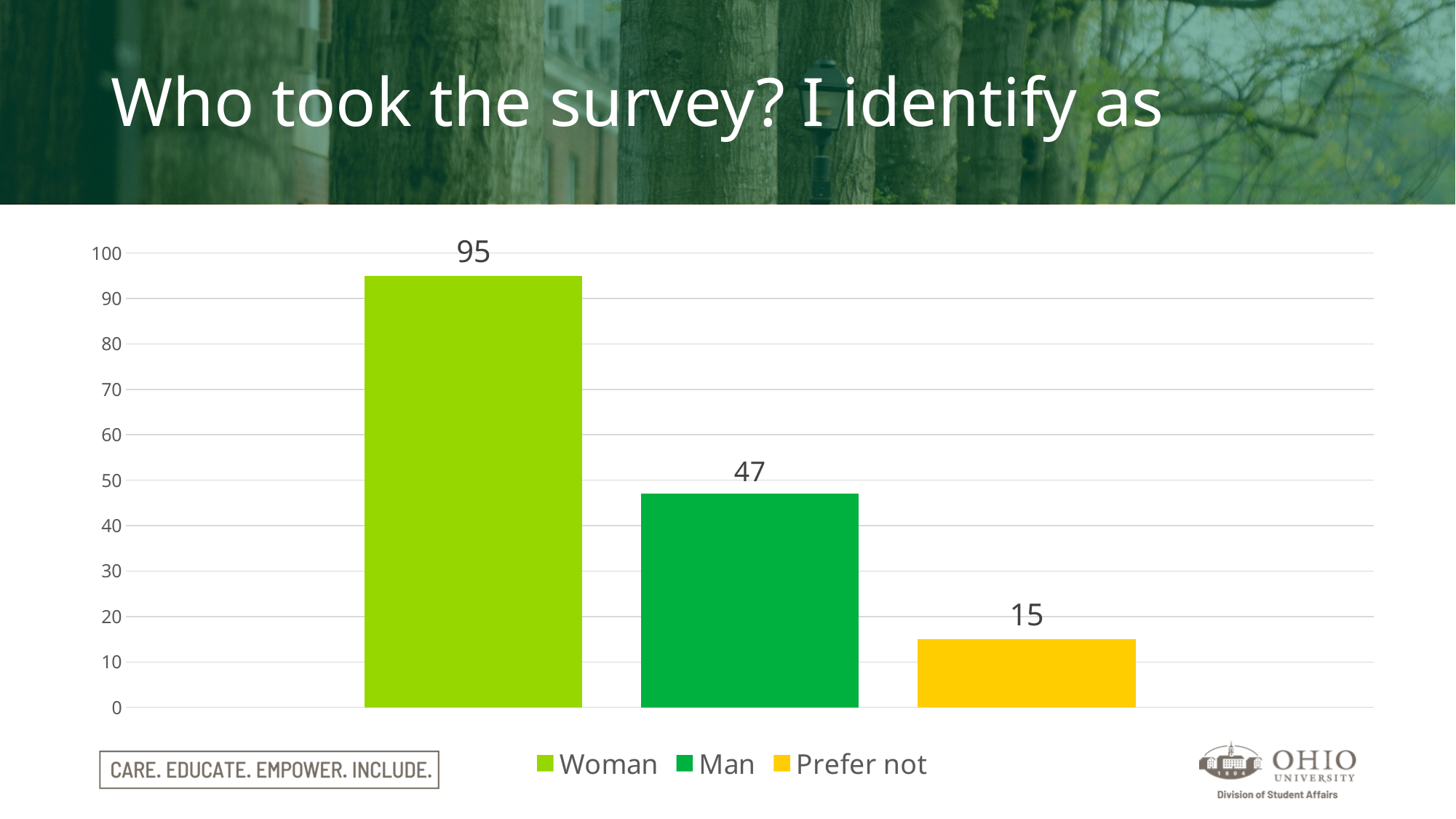
What is the title of the slide? Who took the survey? I identify as What is the difference between the values for Woman and Man? 48 What is the difference between the values for Man and Prefer not? 32 What is the value for Prefer not? 15 What is the value for Man? 47 Is the value for Man greater or less than 50? less How many categories are shown in the chart? 3 Which category has the lowest value? Prefer not Which category has the highest value? Woman What is the value for Woman? 95 What kind of chart is shown on the slide? bar chart Which is larger, the value for Man or the value for Prefer not? Man